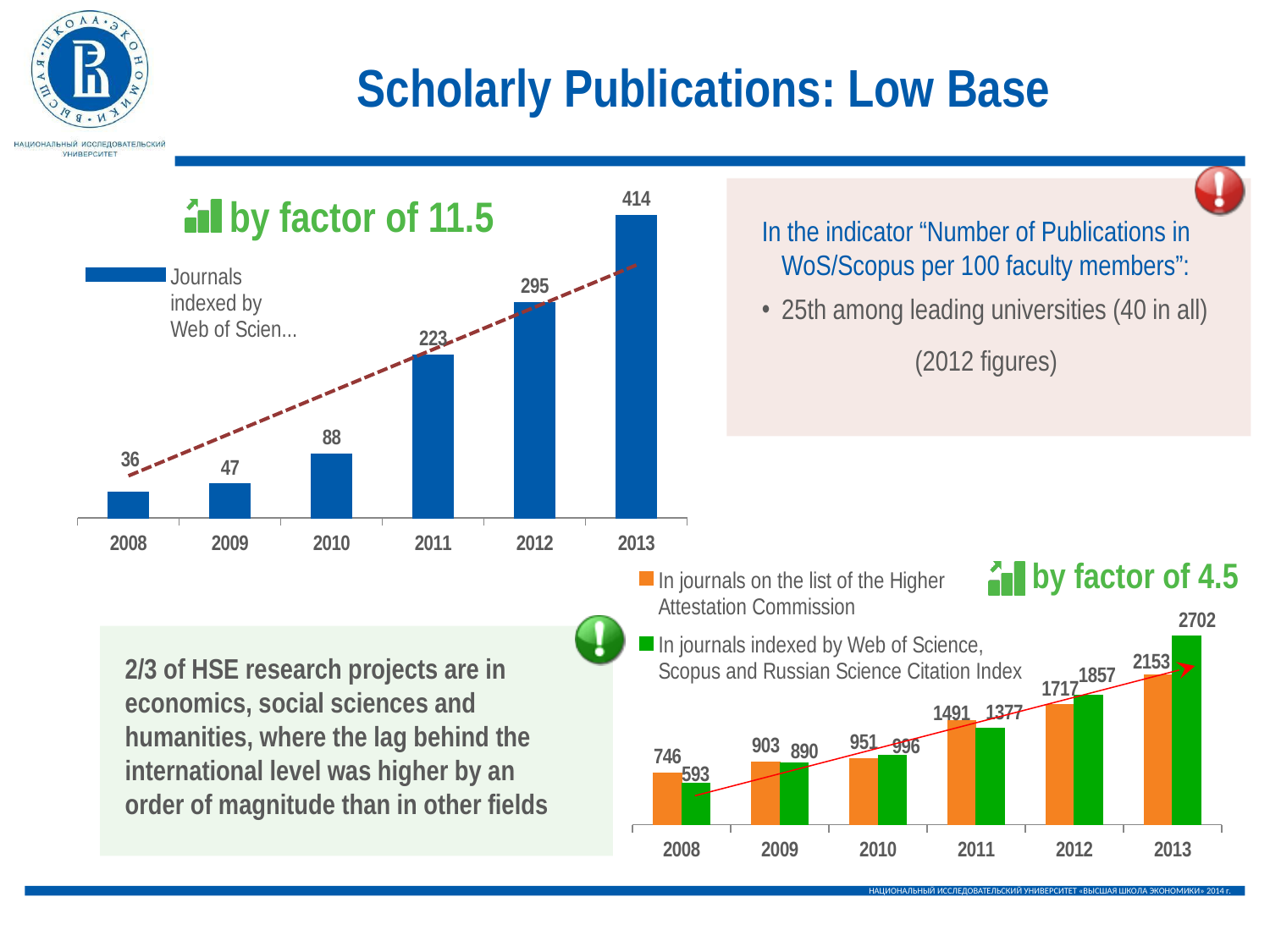
In the top-left chart, do the values rise or fall from 2008 to 2013? rise In the top-left chart, what is the difference between the values for 2012 and 2011? 72 In the bottom-right chart, how many series does the legend list? 2 In the bottom-right chart, what is the value for journals indexed by Web of Science, Scopus and Russian Science Citation Index in 2013? 2702 In the top-left chart, how many years are shown on the x axis? 6 In the top-left chart, what is the value for 2013? 414 In the bottom-right chart, what is the difference between the two series' values in 2013? 549 In the top-left chart, what is the value for 2010? 88 What kind of chart is the top-left chart? bar chart In the bottom-right chart, which series has the larger value in 2008? In journals on the list of the Higher Attestation Commission In the top-left chart, which year has the lowest value? 2008 In the bottom-right chart, what is the value for journals on the list of the Higher Attestation Commission in 2011? 1491